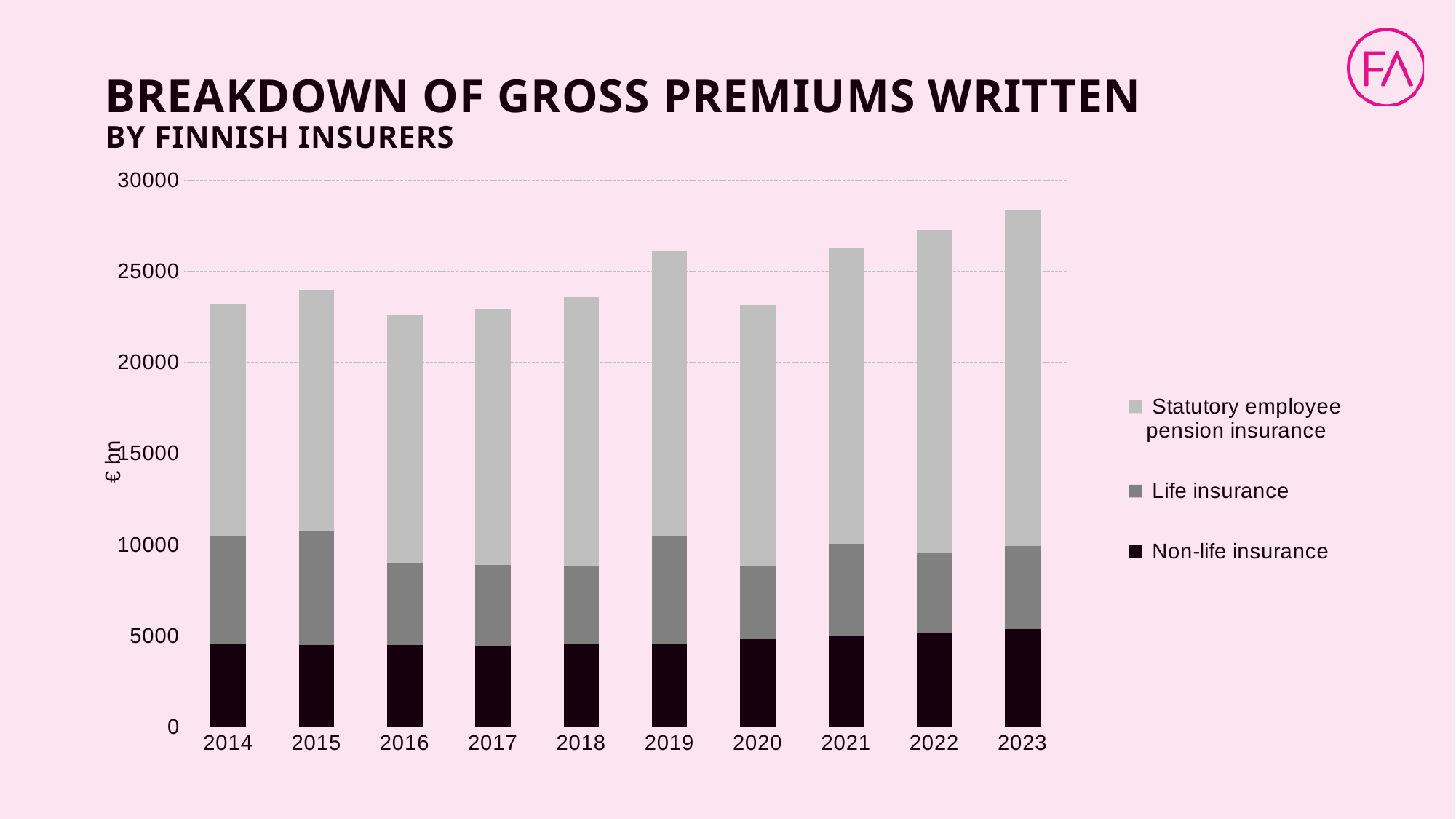
Which year has the highest total gross premiums written? 2023 What is the label on the y axis of the chart? € bn How many series does the legend list? 3 Is the total for 2023 greater or less than 25000? greater Which year has the larger total, 2022 or 2021? 2022 Do the total gross premiums rise or fall from 2020 to 2023? rise Is the total for 2019 greater or less than 25000? greater Is the top of the Life insurance segment in 2020 above or below 10000? below What kind of chart is shown on the slide? Stacked bar chart Which year has the lowest total gross premiums written? 2016 How many years are shown on the x axis of the chart? 10